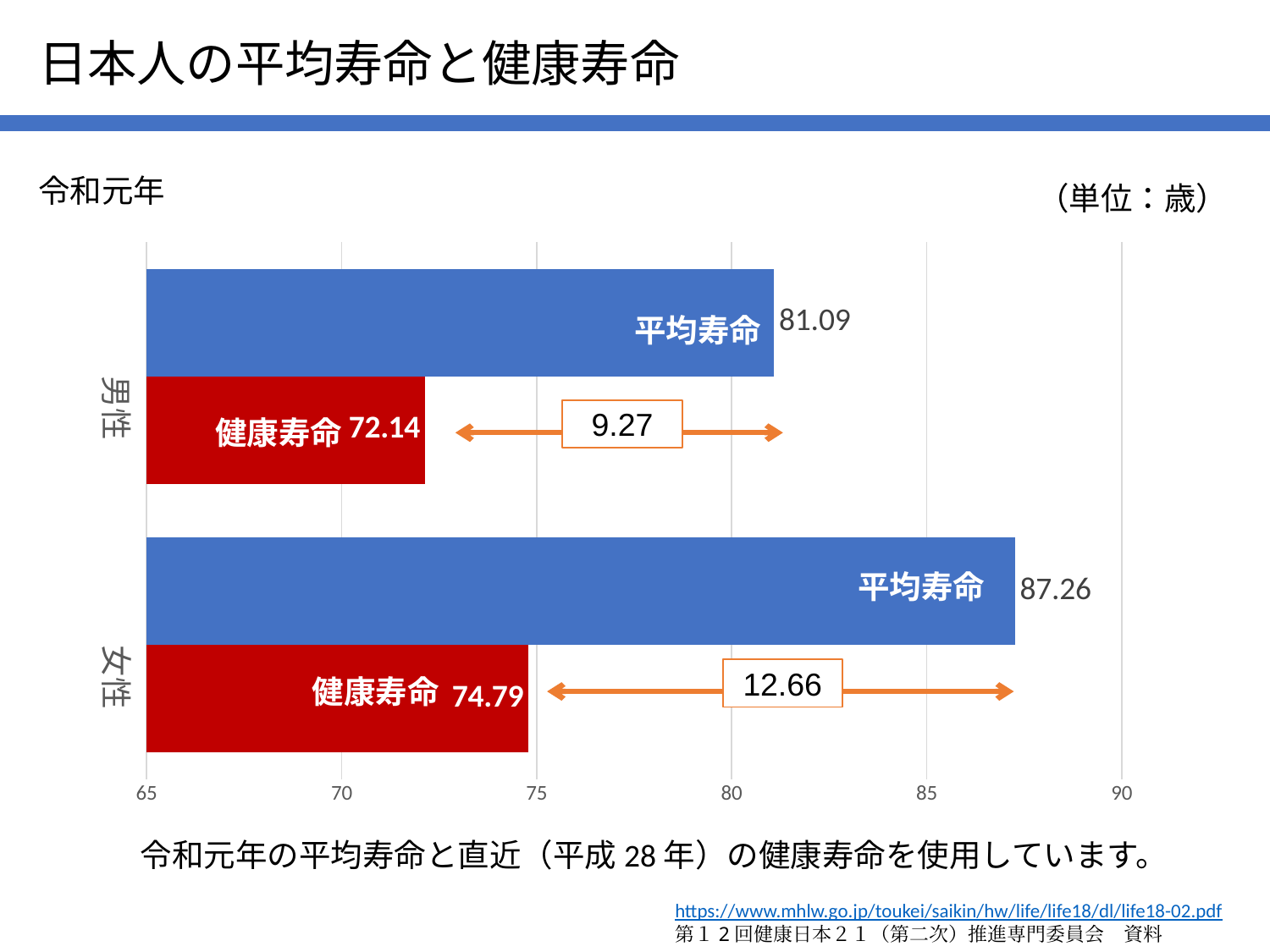
Is the 健康寿命 value for 女性 greater or less than 75? less Which bar has the highest value in the chart? 女性 平均寿命 (87.26) What is the difference between 平均寿命 and 健康寿命 for 男性, as shown on the slide? 9.27 What unit are the values in the chart expressed in? 歳 What type of chart is shown on the slide? Bar chart What is the 健康寿命 (healthy life expectancy) value for 女性 (women)? 74.79 Which is larger: the 平均寿命 for 男性 or the 平均寿命 for 女性? 女性 What is the 健康寿命 value for 男性? 72.14 Which bar has the lowest value in the chart? 男性 健康寿命 (72.14) What is the 平均寿命 value for 女性? 87.26 What is the difference between 平均寿命 and 健康寿命 for 女性, as shown on the slide? 12.66 What is the 平均寿命 (average life expectancy) value for 男性 (men)? 81.09